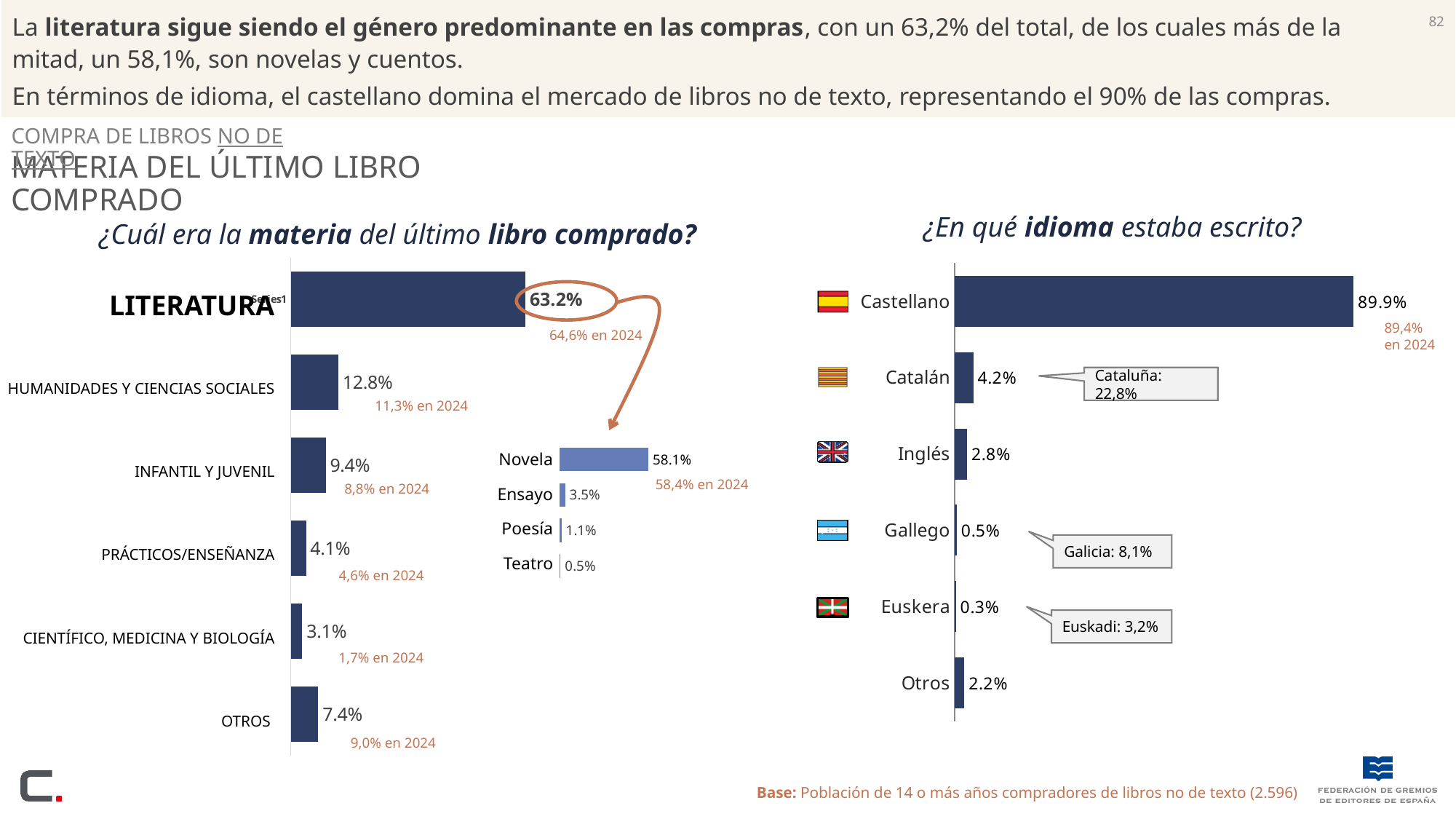
In the chart '¿En qué idioma estaba escrito?', which language has the highest value? Castellano What type of chart is '¿En qué idioma estaba escrito?'? Bar chart In the chart '¿Cuál era la materia del último libro comprado?', what is the difference between INFANTIL Y JUVENIL and PRÁCTICOS/ENSEÑANZA? 5.3% In the small breakdown chart of literature on the left, what is the value for Teatro? 0.5% In the chart '¿Cuál era la materia del último libro comprado?', which category has the lowest value? CIENTÍFICO, MEDICINA Y BIOLOGÍA In the chart '¿En qué idioma estaba escrito?', what is the value for Castellano? 89.9% In the chart '¿Cuál era la materia del último libro comprado?', how many categories are shown in the main bar chart? 6 In the small breakdown chart of literature on the left, what is the value for Novela? 58.1% In the chart '¿Cuál era la materia del último libro comprado?', what is the value for LITERATURA? 63.2% In the chart '¿En qué idioma estaba escrito?', what is the difference between Catalán and Inglés? 1.4% In the chart '¿Cuál era la materia del último libro comprado?', what is the value for HUMANIDADES Y CIENCIAS SOCIALES? 12.8% In the chart '¿Cuál era la materia del último libro comprado?', which is larger: OTROS or PRÁCTICOS/ENSEÑANZA? OTROS